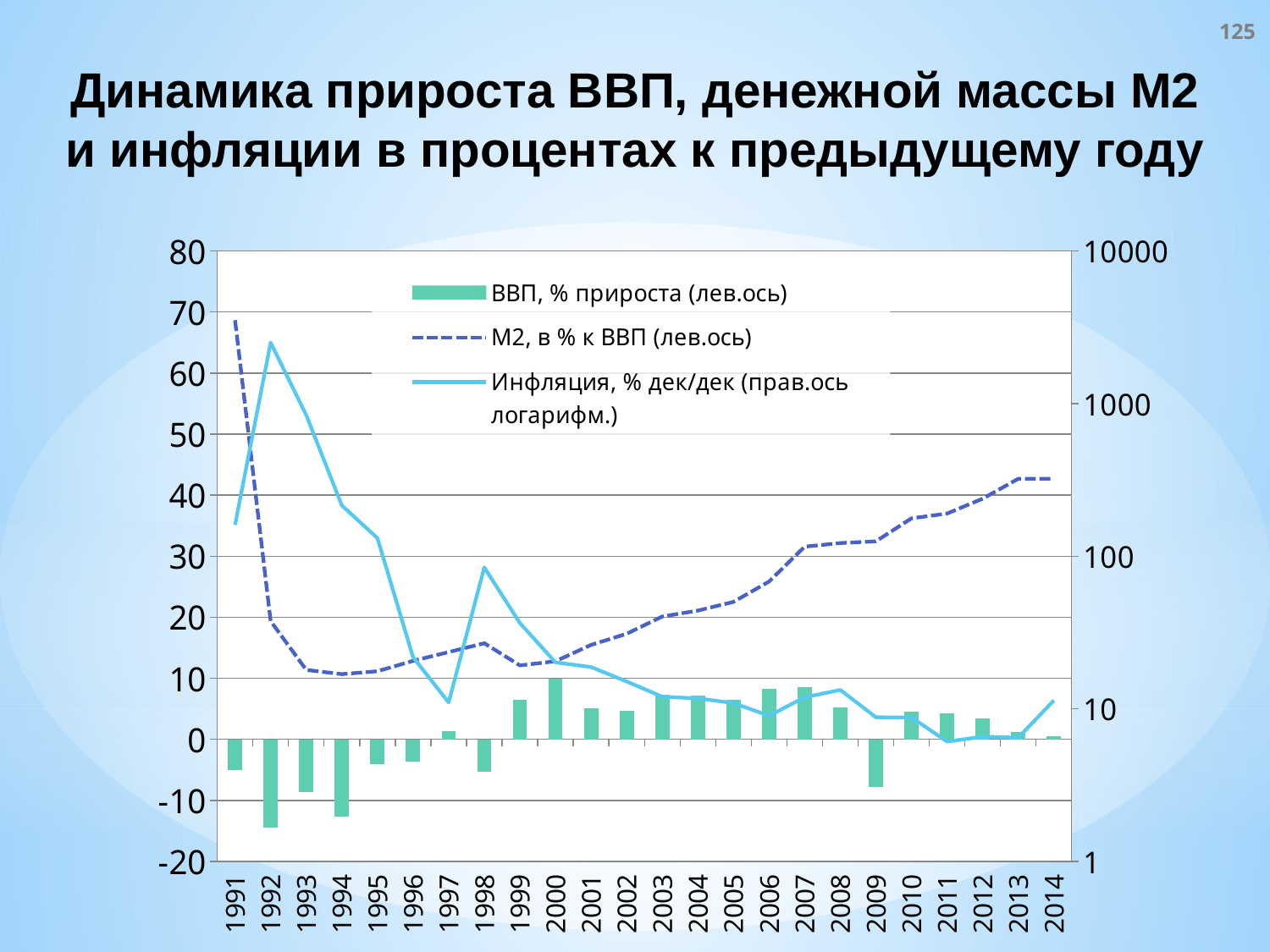
How many series does the legend list? 3 How many years are shown along the x axis? 24 In which year is the GDP growth bar (ВВП, % прироста) the highest? 2000 What is the legend label for the bar series? ВВП, % прироста (лев.ось) In which year is the GDP growth bar (ВВП, % прироста) the lowest? 1992 Is the GDP growth value for 1992 greater or less than -10? less Which year has the larger GDP growth value, 2009 or 2010? 2010 Is the inflation value for 1992 on the right axis greater or less than 1000? greater Is the M2 (в % к ВВП) value for 1994 greater or less than 20? less Does the M2 (в % к ВВП) line rise or fall from 1994 to 2014? rises What kind of chart is this? Combined bar and line chart